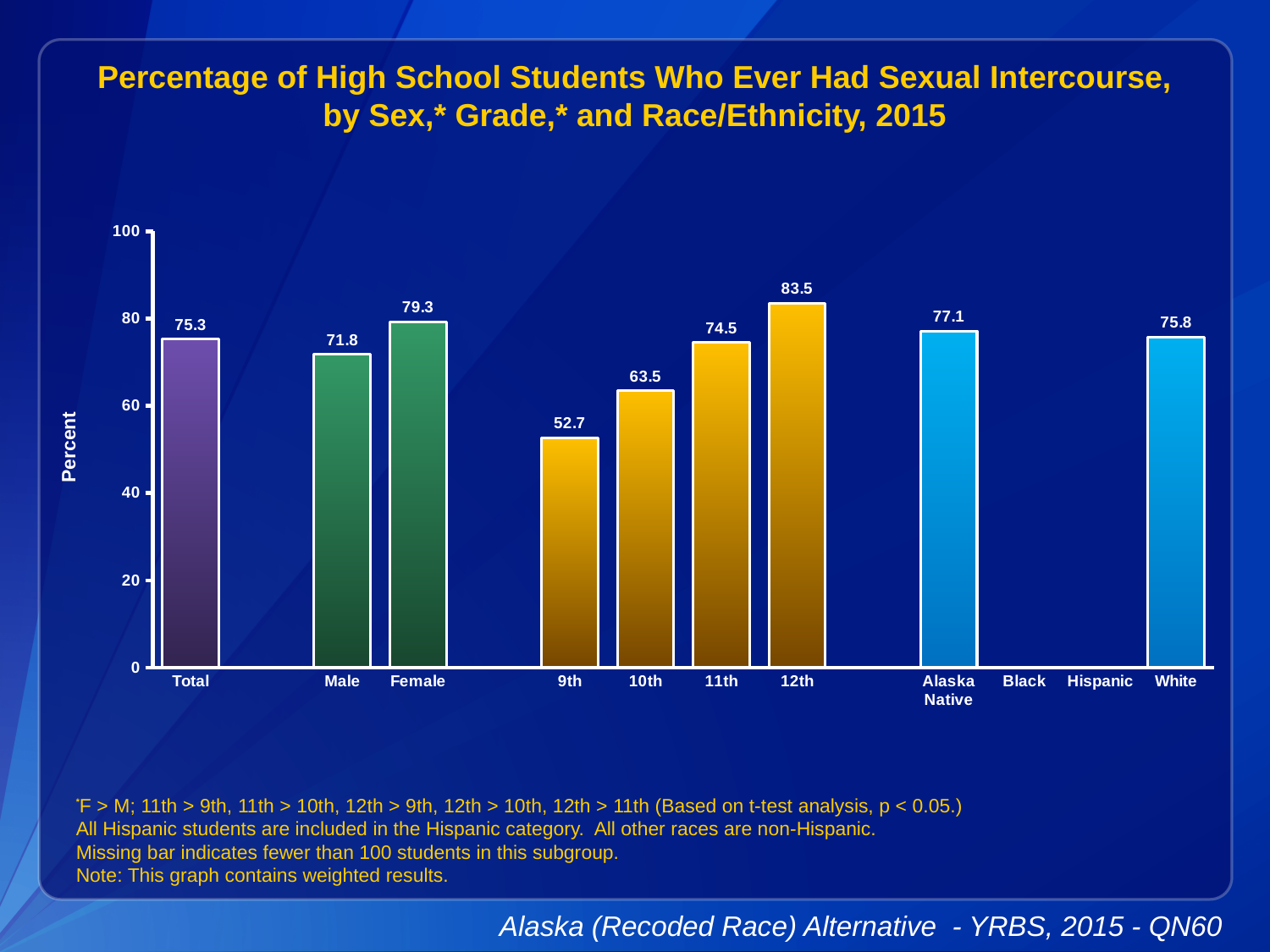
What kind of chart is shown? bar chart What is the value for 9th grade? 52.7 What is the difference between the Female and Male values? 7.5 What is the value for Female? 79.3 Which category has the lowest value? 9th Which is larger, the value for 10th grade or the value for 11th grade? 11th Is the value for White greater or less than 60? greater Which category has the highest value? 12th What is the value for Alaska Native? 77.1 How many bars are plotted on the chart? 9 What is the value for Total? 75.3 Which categories on the x axis have no bar shown? Black and Hispanic